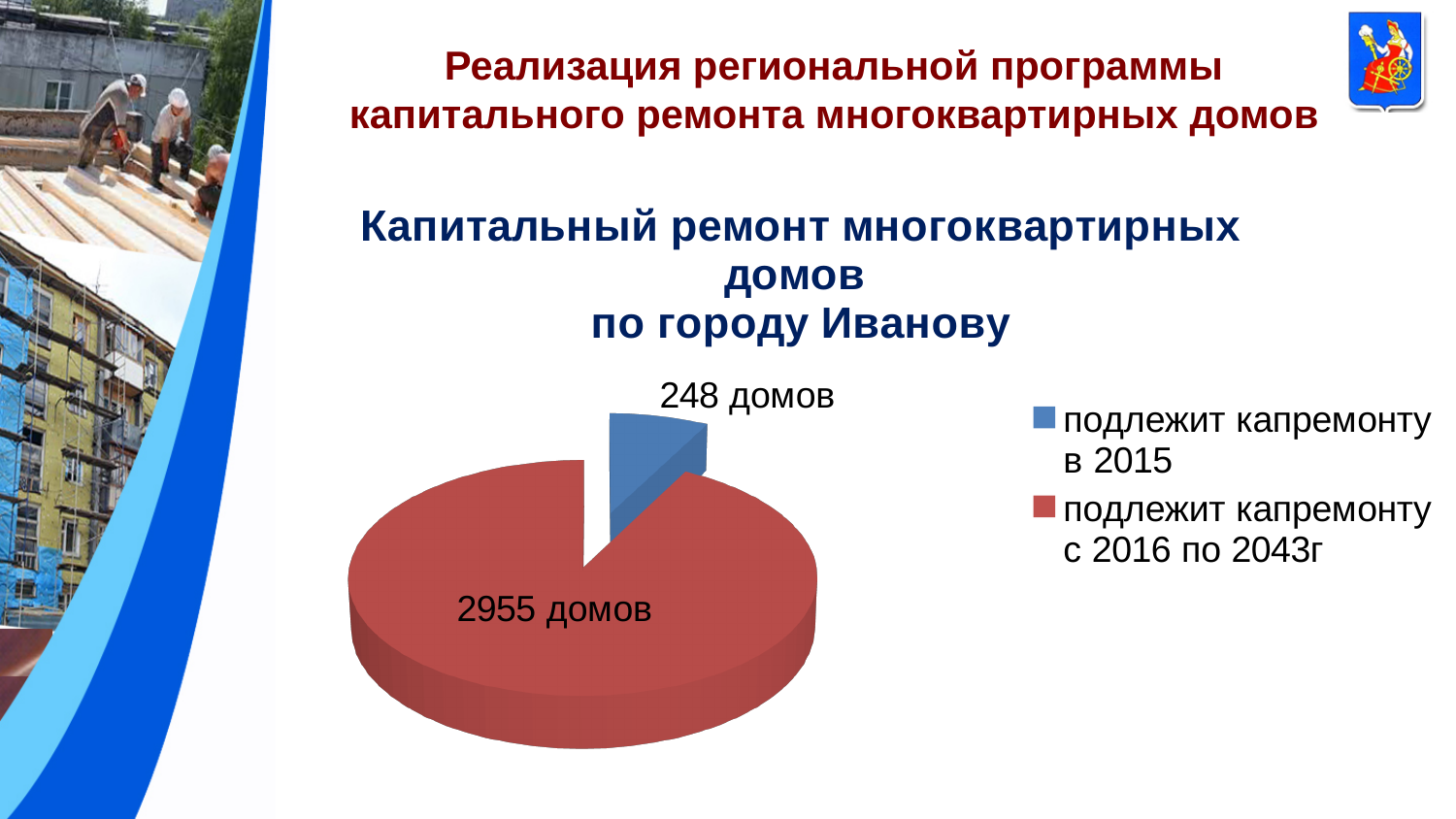
How many slices does the pie chart have? 2 How many houses are subject to capital repair in 2015 (подлежит капремонту в 2015)? 248 домов How many houses are subject to capital repair from 2016 to 2043 (подлежит капремонту с 2016 по 2043г)? 2955 домов What kind of chart is shown on the slide? pie chart How many entries does the legend list? 2 Which category has the largest slice of the pie? подлежит капремонту с 2016 по 2043г What colour is the slice for houses subject to capital repair in 2015? blue What is the difference between the number of houses to be repaired in 2016–2043 and the number to be repaired in 2015? 2707 Which category has the smallest slice of the pie? подлежит капремонту в 2015 What is the total number of houses represented in the pie chart? 3203 Which is larger: the number of houses to be repaired in 2015 or the number to be repaired from 2016 to 2043? подлежит капремонту с 2016 по 2043г